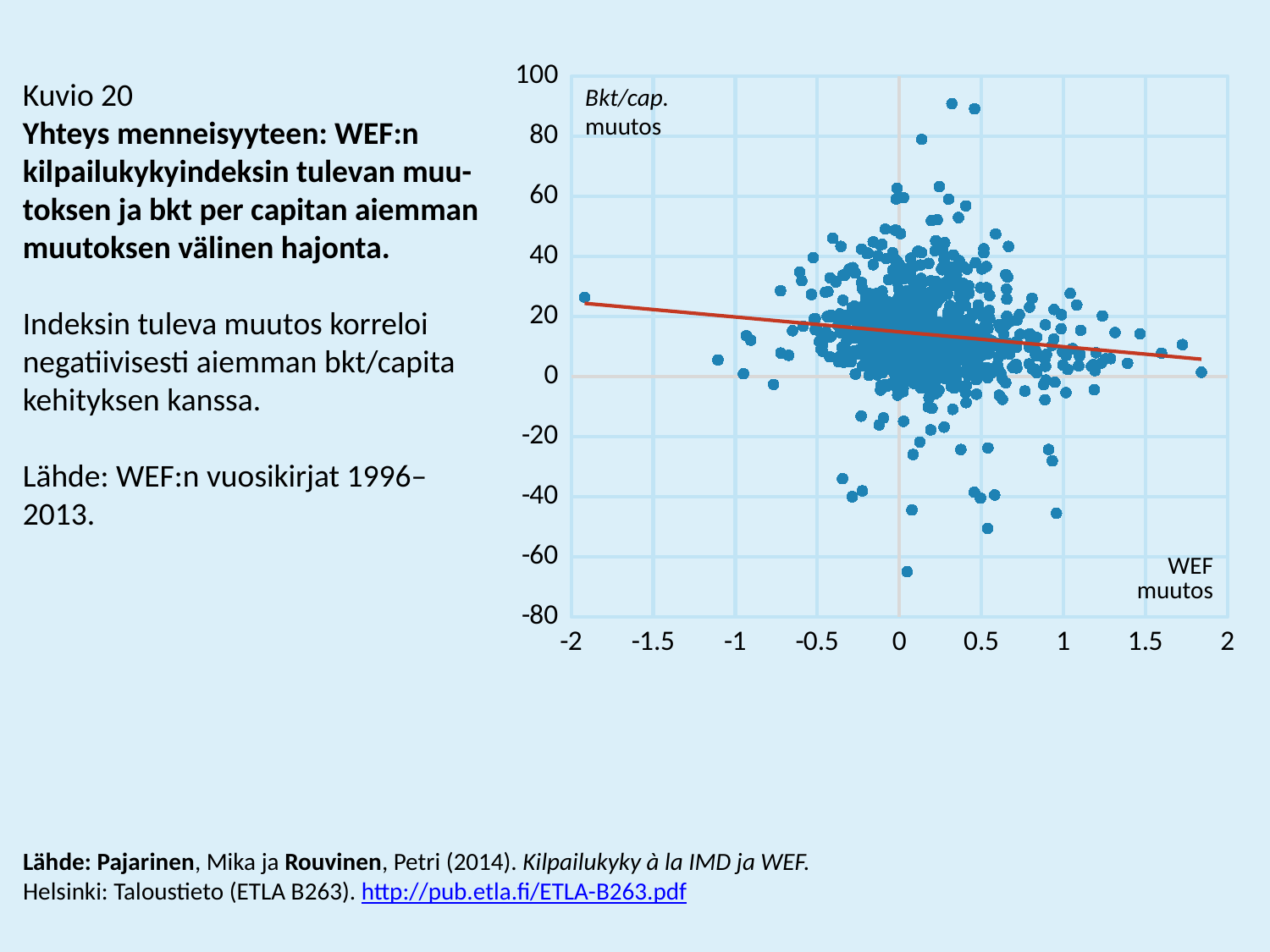
What is the minimum value shown on the vertical axis? -80 What range does the horizontal axis cover? -2 to 2 What kind of chart is shown on the slide? scatter plot What is the maximum value shown on the vertical axis? 100 Is the lowest plotted point's Bkt/cap. muutos value greater or less than -60? less What label is given to the vertical axis of the chart? Bkt/cap. muutos Is the highest plotted point's Bkt/cap. muutos value greater or less than 80? greater Does the fitted trend line rise or fall as WEF muutos increases along the x axis? fall What label is given to the horizontal axis of the chart? WEF muutos Is the Bkt/cap. muutos value of the leftmost point (near WEF muutos -2) greater or less than 20? greater Is the trend line higher at WEF muutos -2 or at WEF muutos 2? -2